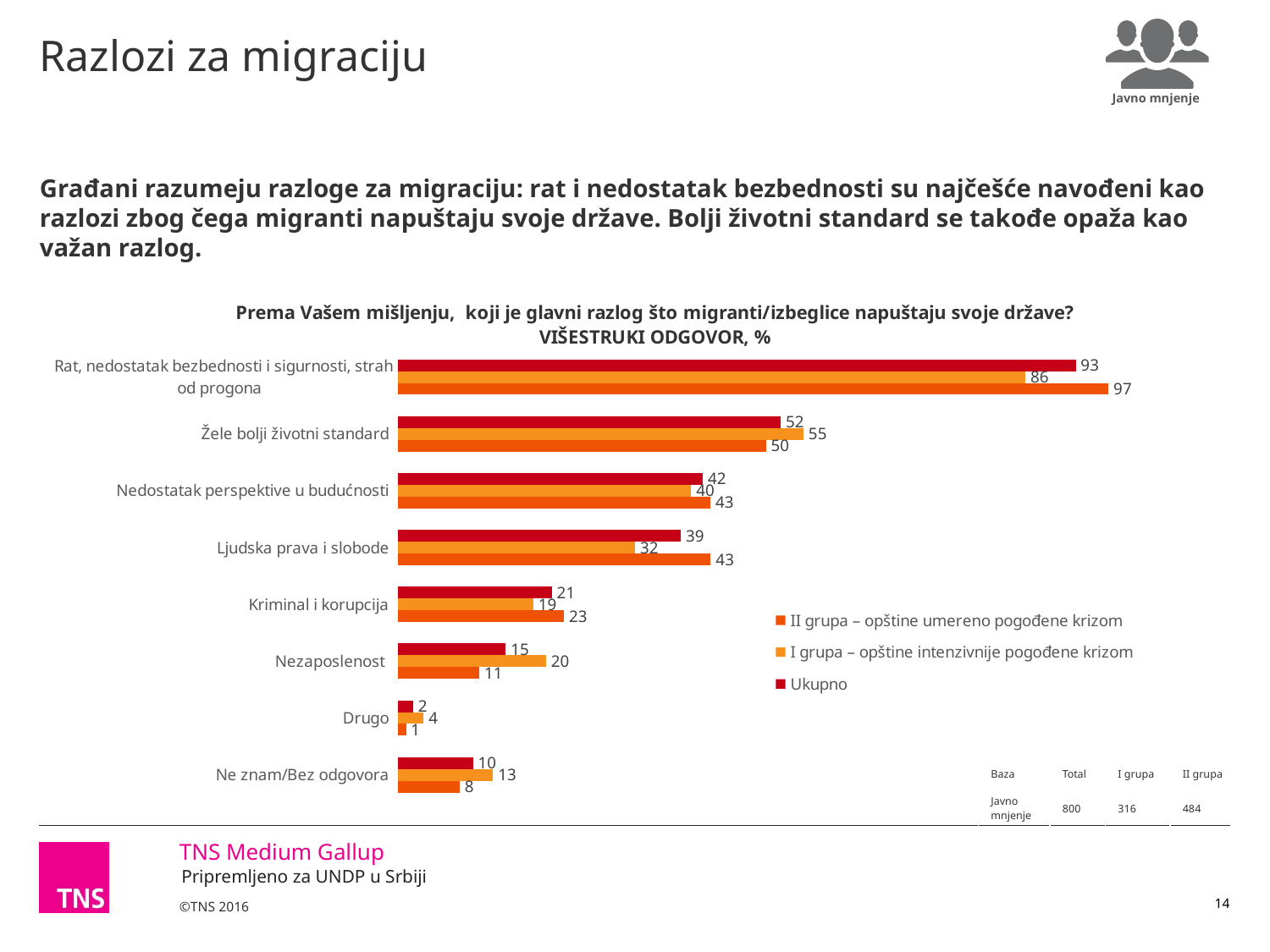
What is the value for "II grupa – opštine umereno pogođene krizom" for "Žele bolji životni standard"? 50 Which category has the lowest Ukupno value? Drugo What kind of chart is shown on the slide? Bar chart What is the Ukupno value for "Rat, nedostatak bezbednosti i sigurnosti, strah od progona"? 93 For "Nezaposlenost", which is larger: the I grupa value or the II grupa value? I grupa – opštine intenzivnije pogođene krizom Which category has the highest Ukupno value? Rat, nedostatak bezbednosti i sigurnosti, strah od progona What is the value for "I grupa – opštine intenzivnije pogođene krizom" for "Ljudska prava i slobode"? 32 What is the difference between the II grupa and I grupa values for "Rat, nedostatak bezbednosti i sigurnosti, strah od progona"? 11 What is the Ukupno value for "Ne znam/Bez odgovora"? 10 How many series does the legend list? 3 What is the difference between the Ukupno values for "Žele bolji životni standard" and "Nedostatak perspektive u budućnosti"? 10 How many categories are shown on the chart? 8